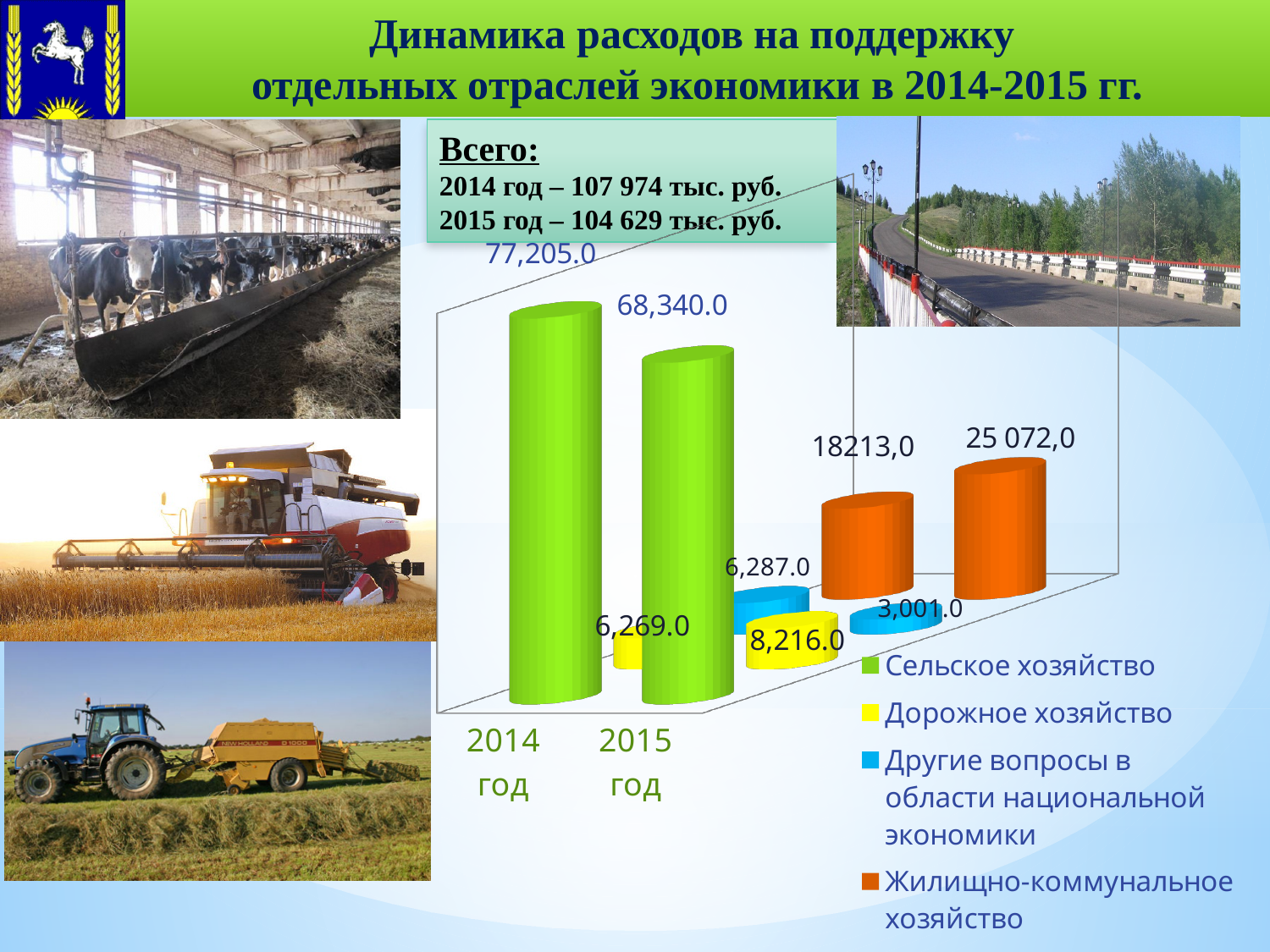
What is the value for Сельское хозяйство in 2015 год? 68,340.0 What is the value for Жилищно-коммунальное хозяйство in 2015 год? 25 072,0 Which is larger: Дорожное хозяйство in 2014 год or in 2015 год? 2015 год Which series has the lowest value in 2015 год? Другие вопросы в области национальной экономики What is the value for Дорожное хозяйство in 2015 год? 8,216.0 What colour represents Жилищно-коммунальное хозяйство in the chart? Orange What is the value for Другие вопросы в области национальной экономики in 2014 год? 6,287.0 How many series does the legend list? 4 By how much did the value for Сельское хозяйство decrease from 2014 год to 2015 год? 8,865.0 What is the value for Сельское хозяйство in 2014 год? 77,205.0 Which series has the highest value in 2014 год? Сельское хозяйство What kind of chart is shown on the slide? Bar chart